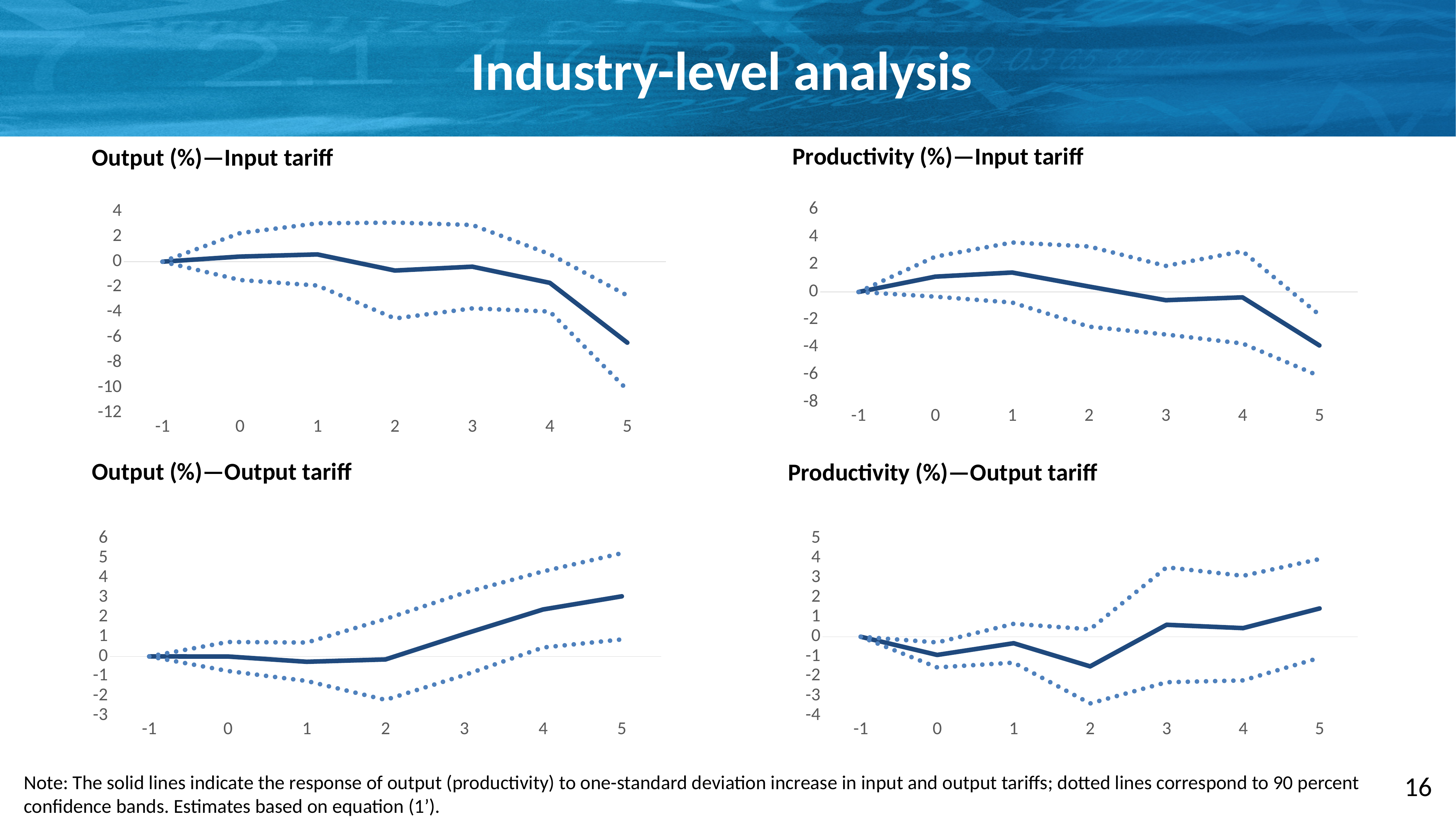
In the Productivity (%)—Output tariff chart, at which x-axis value is the solid line lowest? 2 What kind of chart is the Output (%)—Input tariff chart? line chart How many charts are shown on the slide? 4 In the Output (%)—Input tariff chart, does the solid line rise or fall from 1 to 5 on the x axis? fall In the Productivity (%)—Input tariff chart, is the solid line's value at 5 greater or less than -2? less How many points are on the x axis of the Output (%)—Output tariff chart? 7 In the Productivity (%)—Output tariff chart, is the solid line's value at 2 greater or less than -1? less In the Output (%)—Output tariff chart, is the solid line's value at 5 greater or less than 2? greater In the Output (%)—Output tariff chart, at which x-axis value is the solid line highest? 5 In the Output (%)—Output tariff chart, does the solid line rise or fall from 2 to 5 on the x axis? rise In the Output (%)—Input tariff chart, at which x-axis value is the solid line lowest? 5